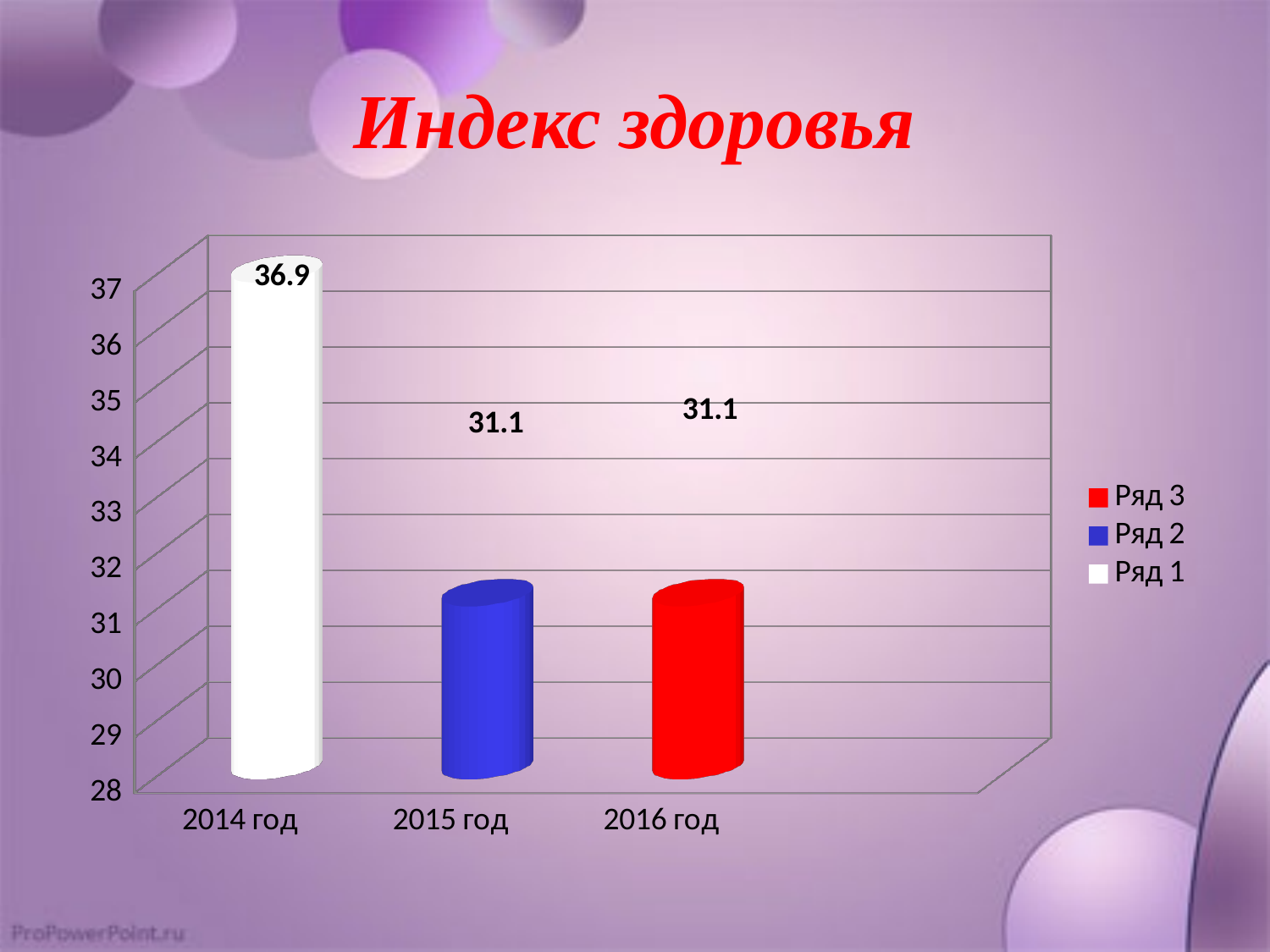
Which year has the highest value? 2014 год What is the difference between the values for 2014 год and 2015 год? 5.8 What is the value for 2014 год? 36.9 How many series does the legend list? 3 Is the value for 2015 год greater or less than 33? less What is the title of the chart? Индекс здоровья What is the value for 2015 год? 31.1 What is the value for 2016 год? 31.1 Is the value for 2014 год greater or less than 35? greater What kind of chart is shown on the slide? bar chart How many categories are shown on the x axis? 3 Which is larger, the value for 2014 год or the value for 2016 год? 2014 год